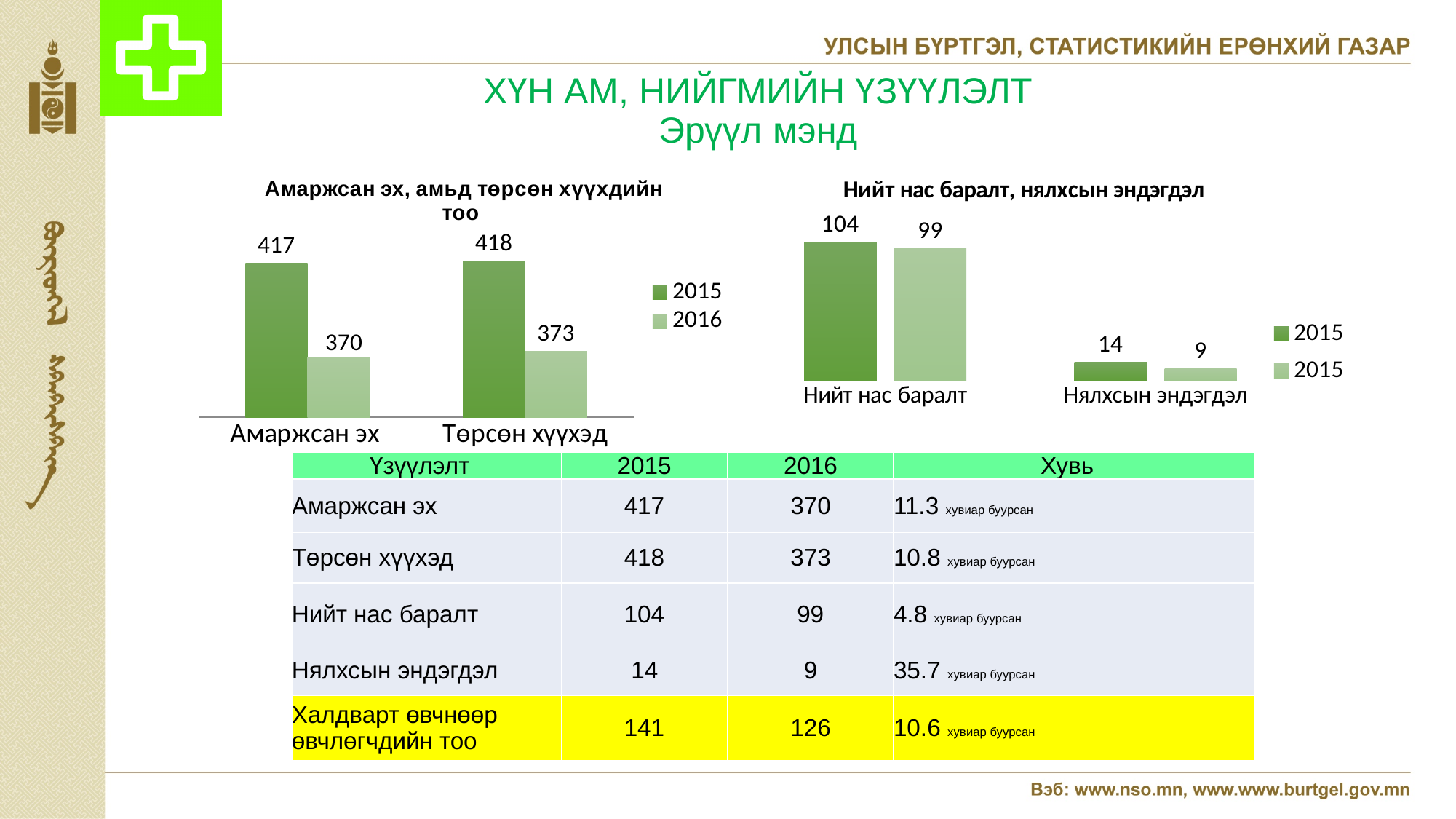
In the left chart titled 'Амаржсан эх, амьд төрсөн хүүхдийн тоо', what is the 2015 value for Амаржсан эх? 417 In the right chart titled 'Нийт нас баралт, нялхсын эндэгдэл', what is the difference between the two bars for Нялхсын эндэгдэл? 5 In the right chart titled 'Нийт нас баралт, нялхсын эндэгдэл', how many categories are shown on the x axis? 2 In the right chart titled 'Нийт нас баралт, нялхсын эндэгдэл', what is the 2015 value for Нийт нас баралт? 104 In the left chart titled 'Амаржсан эх, амьд төрсөн хүүхдийн тоо', what kind of chart is shown? Bar chart In the left chart titled 'Амаржсан эх, амьд төрсөн хүүхдийн тоо', what is the 2016 value for Төрсөн хүүхэд? 373 In the right chart titled 'Нийт нас баралт, нялхсын эндэгдэл', is the 2015 value for Нийт нас баралт larger or smaller than the 2016 value? Larger In the right chart titled 'Нийт нас баралт, нялхсын эндэгдэл', which category has the lowest value? Нялхсын эндэгдэл In the left chart titled 'Амаржсан эх, амьд төрсөн хүүхдийн тоо', how many series does the legend list? 2 In the right chart titled 'Нийт нас баралт, нялхсын эндэгдэл', what is the 2016 value for Нялхсын эндэгдэл? 9 In the left chart titled 'Амаржсан эх, амьд төрсөн хүүхдийн тоо', what is the difference between the 2015 and 2016 values for Амаржсан эх? 47 In the left chart titled 'Амаржсан эх, амьд төрсөн хүүхдийн тоо', which series is shown in the darker green colour? 2015